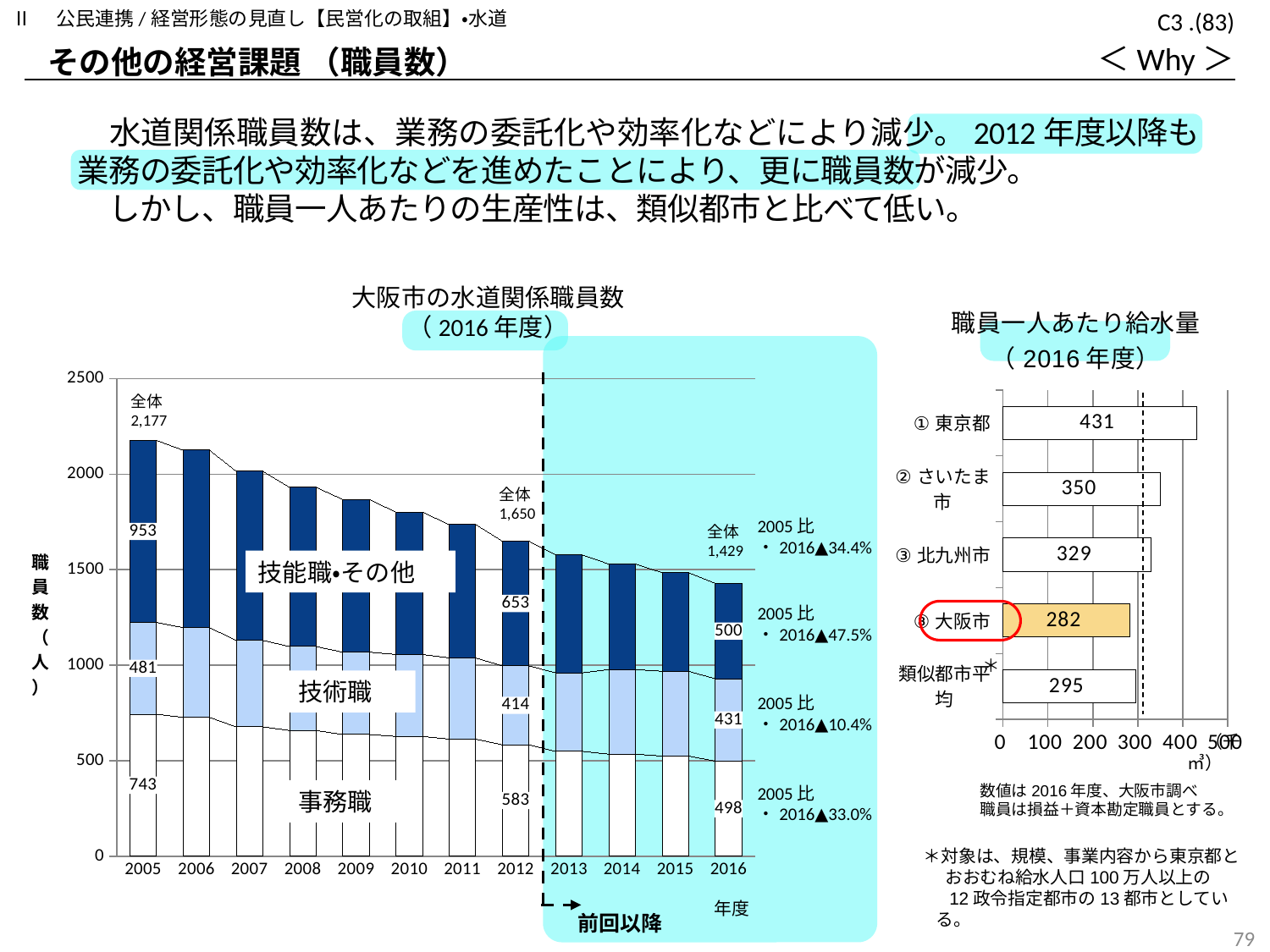
In the chart titled 職員一人あたり給水量（2016年度）, what is the difference between the values for 類似都市平均 and 大阪市? 13 In the chart titled 大阪市の水道関係職員数, what is the 全体 (total) value for 2005? 2,177 In the chart titled 大阪市の水道関係職員数, do the total staff numbers rise or fall from 2005 to 2016? fall In the chart titled 職員一人あたり給水量（2016年度）, what is the value for 東京都? 431 In the chart titled 大阪市の水道関係職員数, how many years are shown on the x axis? 12 In the chart titled 職員一人あたり給水量（2016年度）, which is larger, the value for さいたま市 or 北九州市? さいたま市 In the chart titled 職員一人あたり給水量（2016年度）, which city has the highest value? 東京都 In the chart titled 大阪市の水道関係職員数, what is the 事務職 value for 2016? 498 What kind of chart is the chart titled 職員一人あたり給水量（2016年度）? bar chart In the chart titled 職員一人あたり給水量（2016年度）, what is the value for 大阪市? 282 In the chart titled 大阪市の水道関係職員数, what is the 技術職 value for 2012? 414 In the chart titled 職員一人あたり給水量（2016年度）, which bar has the lowest value? 大阪市